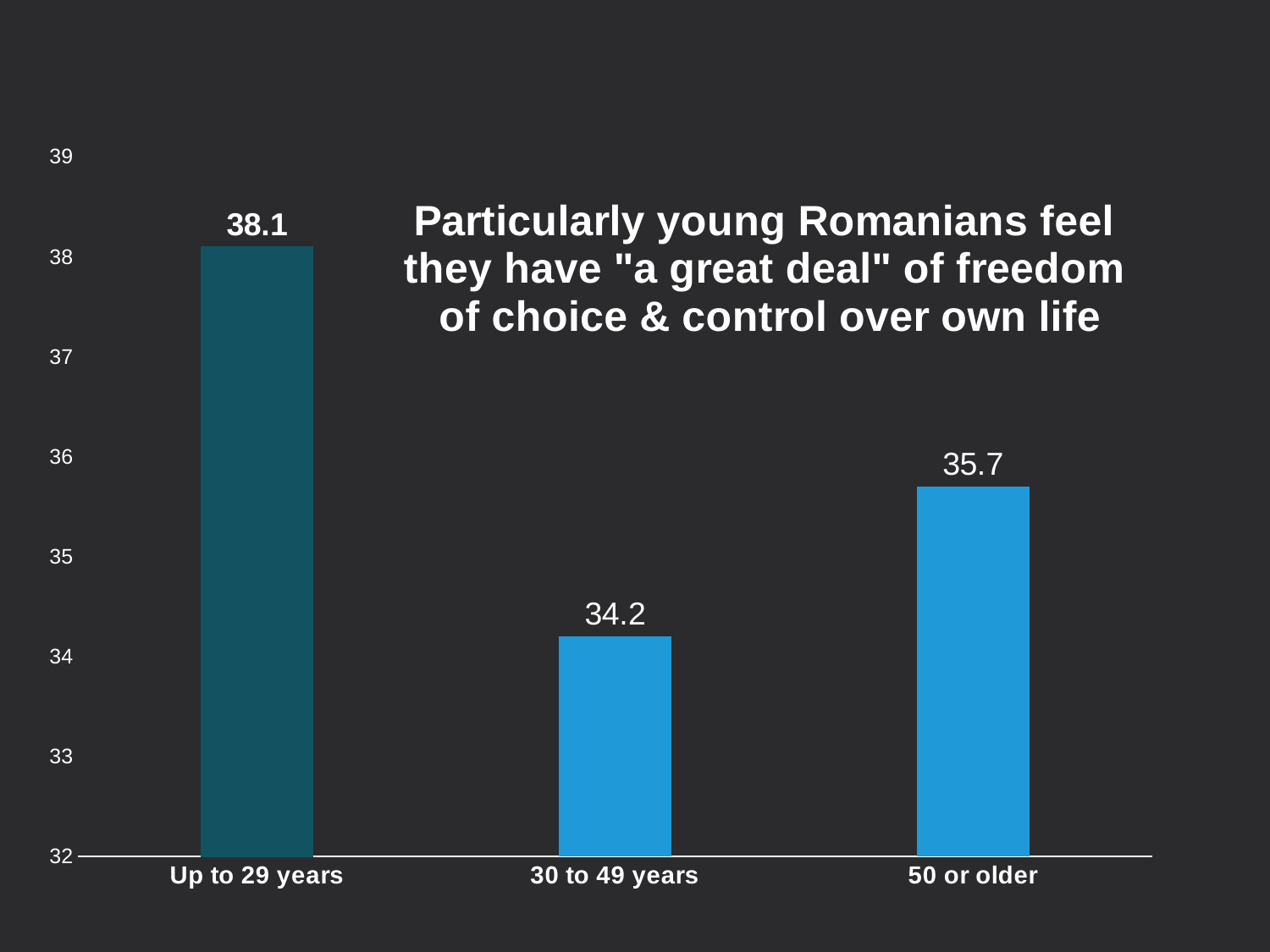
What is the value for the '30 to 49 years' age group? 34.2 What is the difference between the values for '50 or older' and '30 to 49 years'? 1.5 What is the difference between the values for 'Up to 29 years' and '30 to 49 years'? 3.9 Which age group has the highest value? Up to 29 years Which age group has the lowest value? 30 to 49 years What kind of chart is shown on the slide? Bar chart Is the value for 'Up to 29 years' greater or less than 37? greater How many age groups are shown in the chart? 3 Which is larger, the value for '50 or older' or the value for '30 to 49 years'? 50 or older What is the value for the 'Up to 29 years' age group? 38.1 Which bar is shown in a different, darker colour from the others? Up to 29 years What is the value for the '50 or older' age group? 35.7